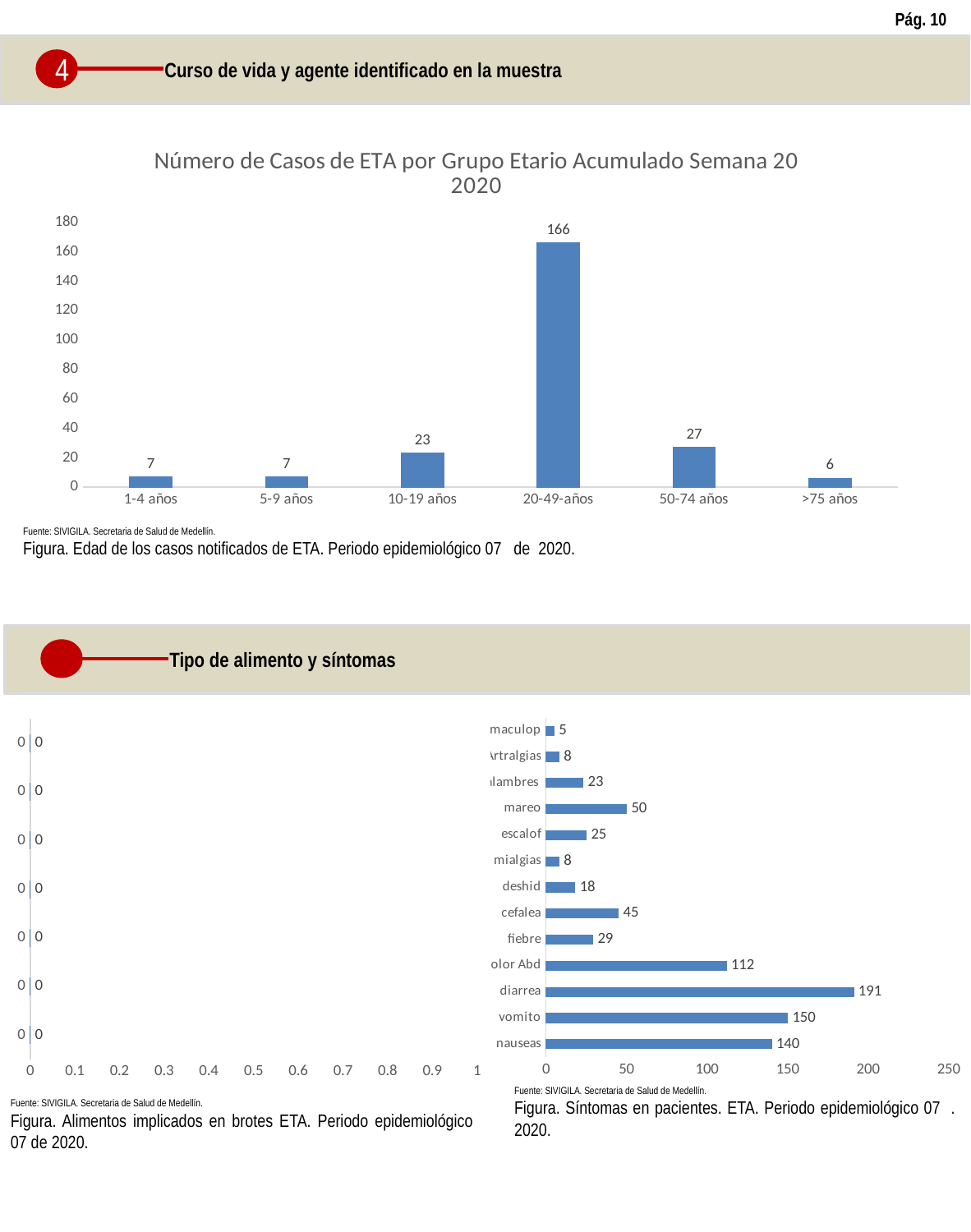
In the chart 'Número de Casos de ETA por Grupo Etario Acumulado Semana 20 2020', is the value for 50-74 años greater or less than 40? less In the bottom-right chart of symptoms (Síntomas en pacientes), what is the value for diarrea? 191 In the chart 'Número de Casos de ETA por Grupo Etario Acumulado Semana 20 2020', what is the difference between the cases for 50-74 años and 10-19 años? 4 What type of chart is 'Número de Casos de ETA por Grupo Etario Acumulado Semana 20 2020'? bar chart In the chart 'Número de Casos de ETA por Grupo Etario Acumulado Semana 20 2020', how many cases are shown for the 20-49-años group? 166 In the chart 'Número de Casos de ETA por Grupo Etario Acumulado Semana 20 2020', how many age groups are shown? 6 In the chart 'Número de Casos de ETA por Grupo Etario Acumulado Semana 20 2020', which age group has the lowest number of cases? >75 años In the bottom-right chart of symptoms (Síntomas en pacientes), what is the difference between the values for nauseas and mareo? 90 In the bottom-right chart of symptoms (Síntomas en pacientes), which symptom has the highest value? diarrea In the chart 'Número de Casos de ETA por Grupo Etario Acumulado Semana 20 2020', which age group has the highest number of cases? 20-49-años In the bottom-right chart of symptoms (Síntomas en pacientes), which is larger, the value for cefalea or the value for fiebre? cefalea In the bottom-right chart of symptoms (Síntomas en pacientes), what is the value for vomito? 150